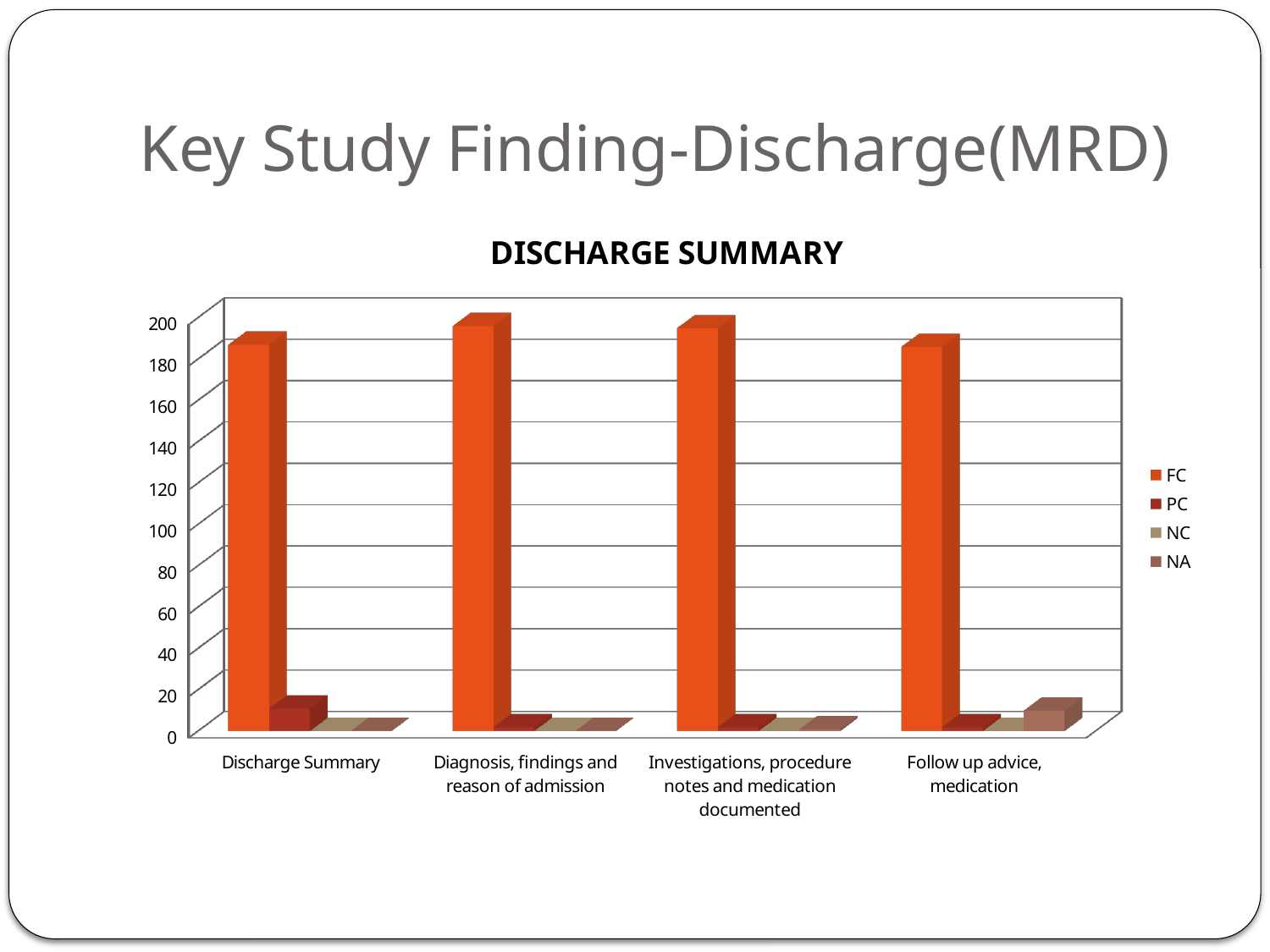
Is the PC value for Discharge Summary greater or less than 40? less Which is larger for Investigations, procedure notes and medication documented: the FC value or the PC value? FC What are the four series names listed in the legend? FC, PC, NC, NA How many categories are shown on the x axis? 4 Which series has the highest value in the Discharge Summary category? FC Is the FC value for Diagnosis, findings and reason of admission greater or less than 180? greater How many series does the legend list? 4 Which series has the highest value in the Follow up advice, medication category? FC What kind of chart is shown on the slide? bar chart Is the FC value for Follow up advice, medication greater or less than 200? less What is the title of the chart? DISCHARGE SUMMARY